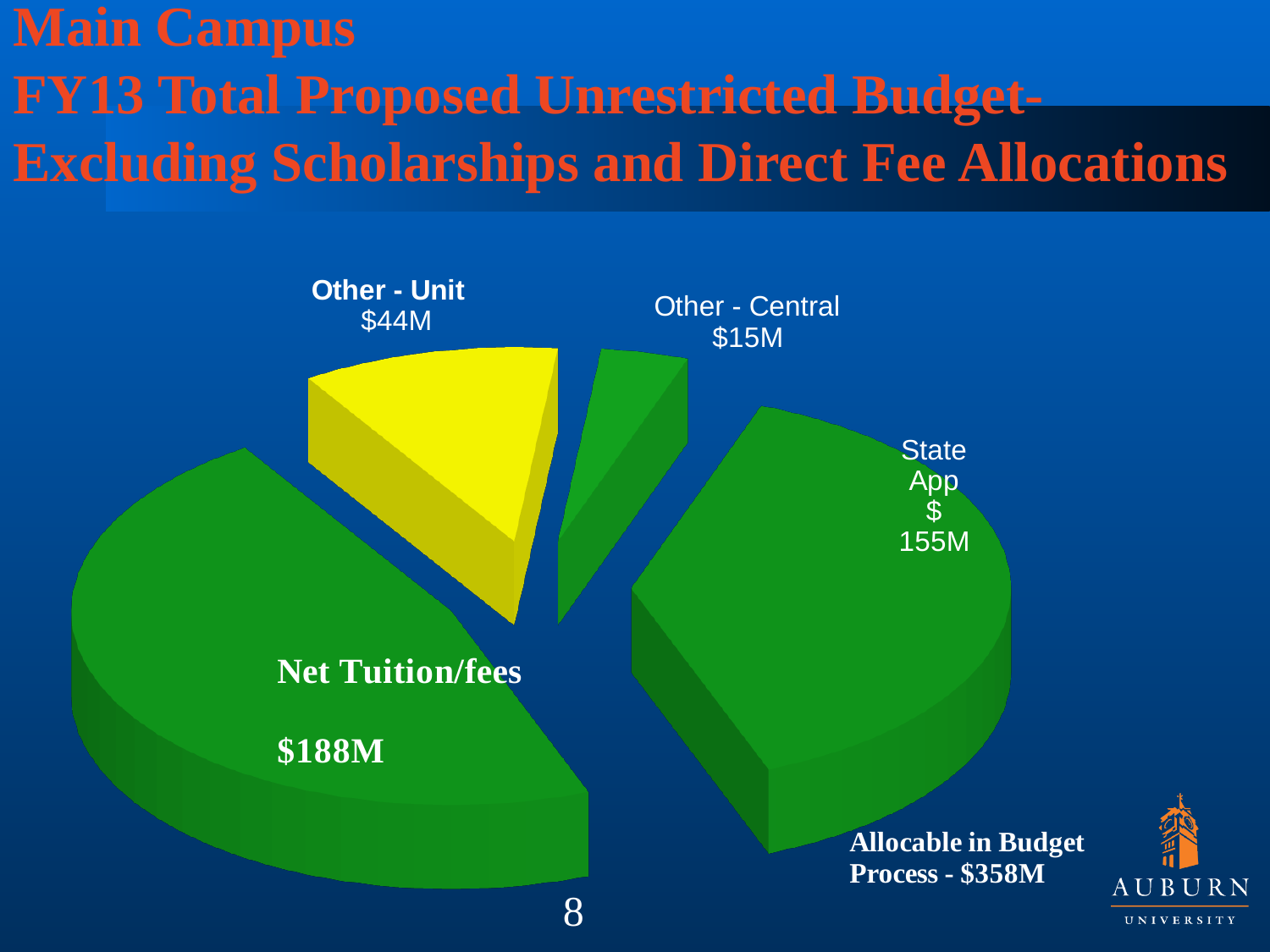
What is the value of the Other - Central slice? $15M What is the value of the Other - Unit slice? $44M How much larger is Net Tuition/fees than State App? $33M Which is larger, Other - Unit or Other - Central? Other - Unit What kind of chart is shown on the slide? Pie chart Which category has the largest slice of the pie? Net Tuition/fees What colour is the Other - Unit slice? Yellow What is the difference between Other - Unit and Other - Central? $29M What is the value of the Net Tuition/fees slice? $188M What is the value of the State App slice? $155M How many slices does the pie chart have? 4 Which category has the smallest slice of the pie? Other - Central